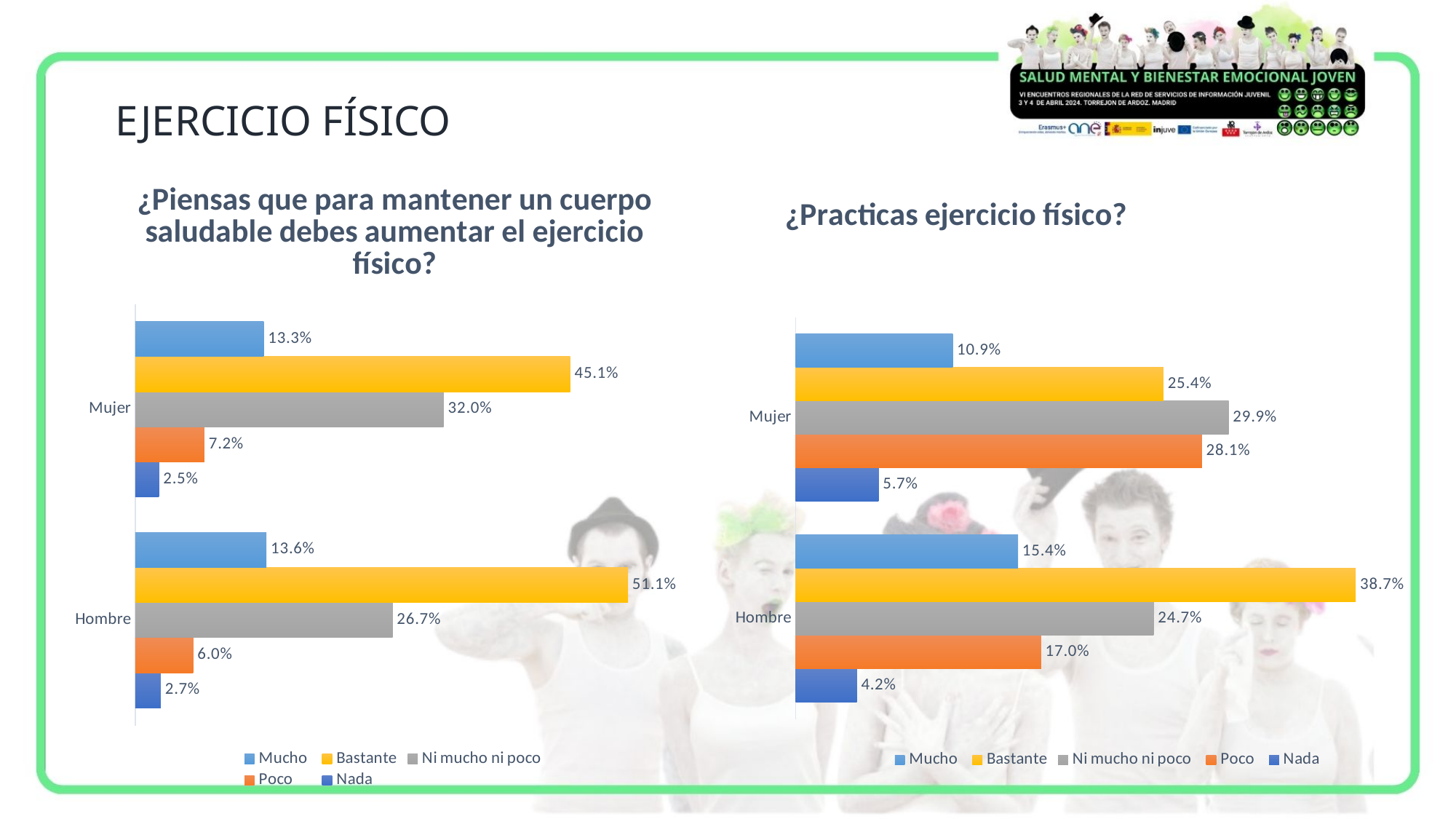
How many series does the legend of the right chart list? 5 How many categories (groups) are shown on the y axis of the right chart? 2 In the chart '¿Practicas ejercicio físico?', what is the difference between the 'Poco' values for Mujer and Hombre? 11.1% In the chart '¿Practicas ejercicio físico?', what is the value for 'Poco' for Mujer? 28.1% In the left chart, which colour represents 'Poco'? Orange In the chart '¿Practicas ejercicio físico?', which response has the lowest value for Mujer? Nada In the chart '¿Piensas que para mantener un cuerpo saludable debes aumentar el ejercicio físico?', what is the value for 'Ni mucho ni poco' for Mujer? 32.0% In the left chart, what is the difference between the 'Bastante' values for Hombre and Mujer? 6.0% What kind of chart is the left chart? Bar chart In the left chart, which response has the highest value for Hombre? Bastante In the chart '¿Practicas ejercicio físico?', what is the value for 'Bastante' for Hombre? 38.7% In the chart '¿Practicas ejercicio físico?', which is larger for Mujer: 'Bastante' or 'Ni mucho ni poco'? Ni mucho ni poco